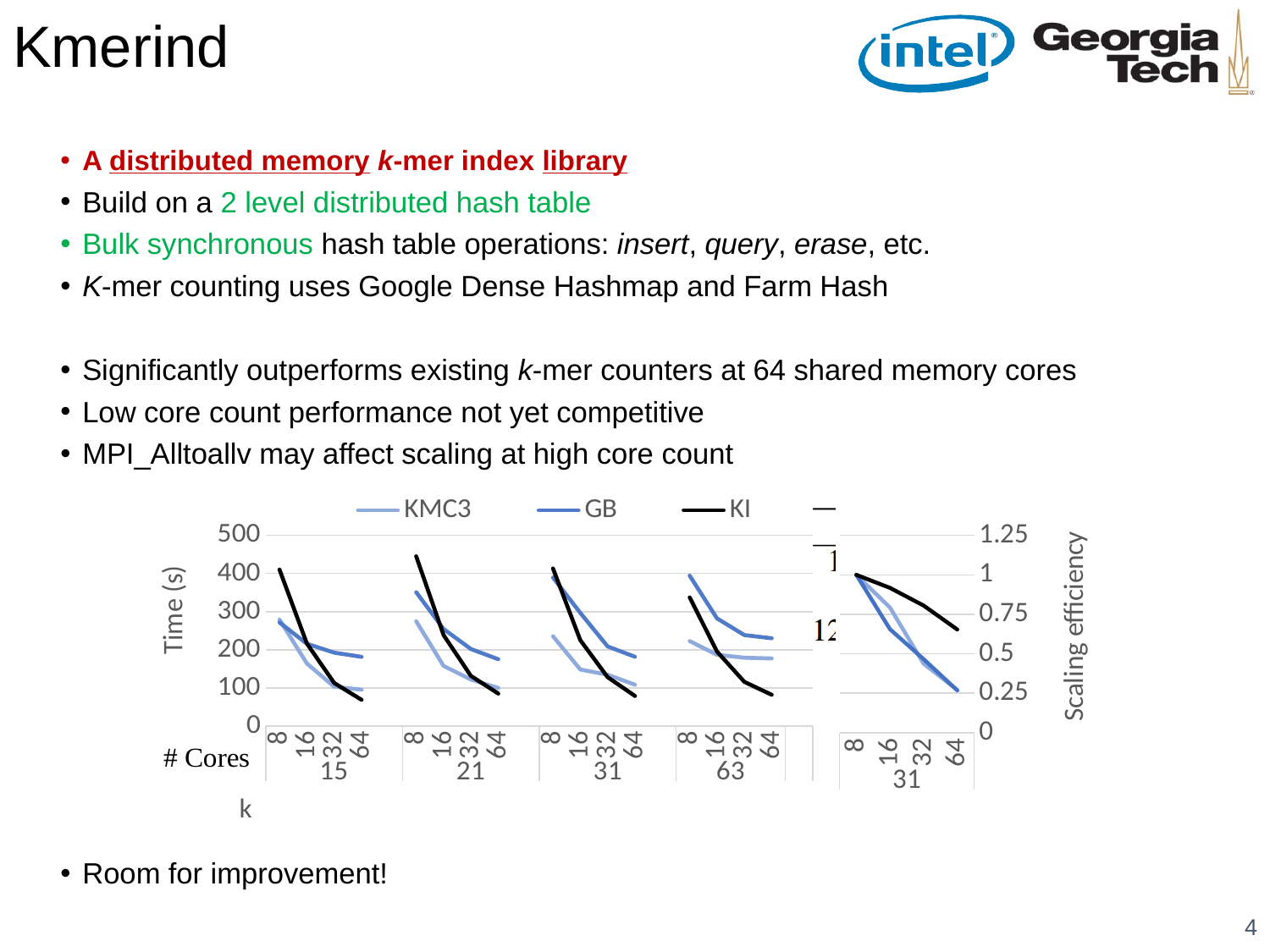
In the left chart (Time (s)), is the KI value at 64 cores for k=15 greater or less than 100? less In the left chart (Time (s)), is the GB value at 64 cores for k=63 greater or less than 200? greater In the left chart (Time (s)), does the KI time rise or fall as the number of cores increases for k=31? fall In the left chart (Time (s)), what is the label of the y axis? Time (s) In the left chart (Time (s)), at 8 cores for k=21, which series has the larger value, KI or GB? KI In the left chart (Time (s)), how many values of k are shown along the x axis? 4 What type of chart is the left chart showing Time (s) against # Cores? line chart In the left chart (Time (s)), what are the series names in the legend? KMC3, GB, KI In the left chart (Time (s)), how many series does the legend list? 3 In the right chart (Scaling efficiency), is the black line's value at 64 cores greater or less than 0.5? greater In the left chart (Time (s)), at 64 cores for k=15, which series has the larger value, GB or KI? GB